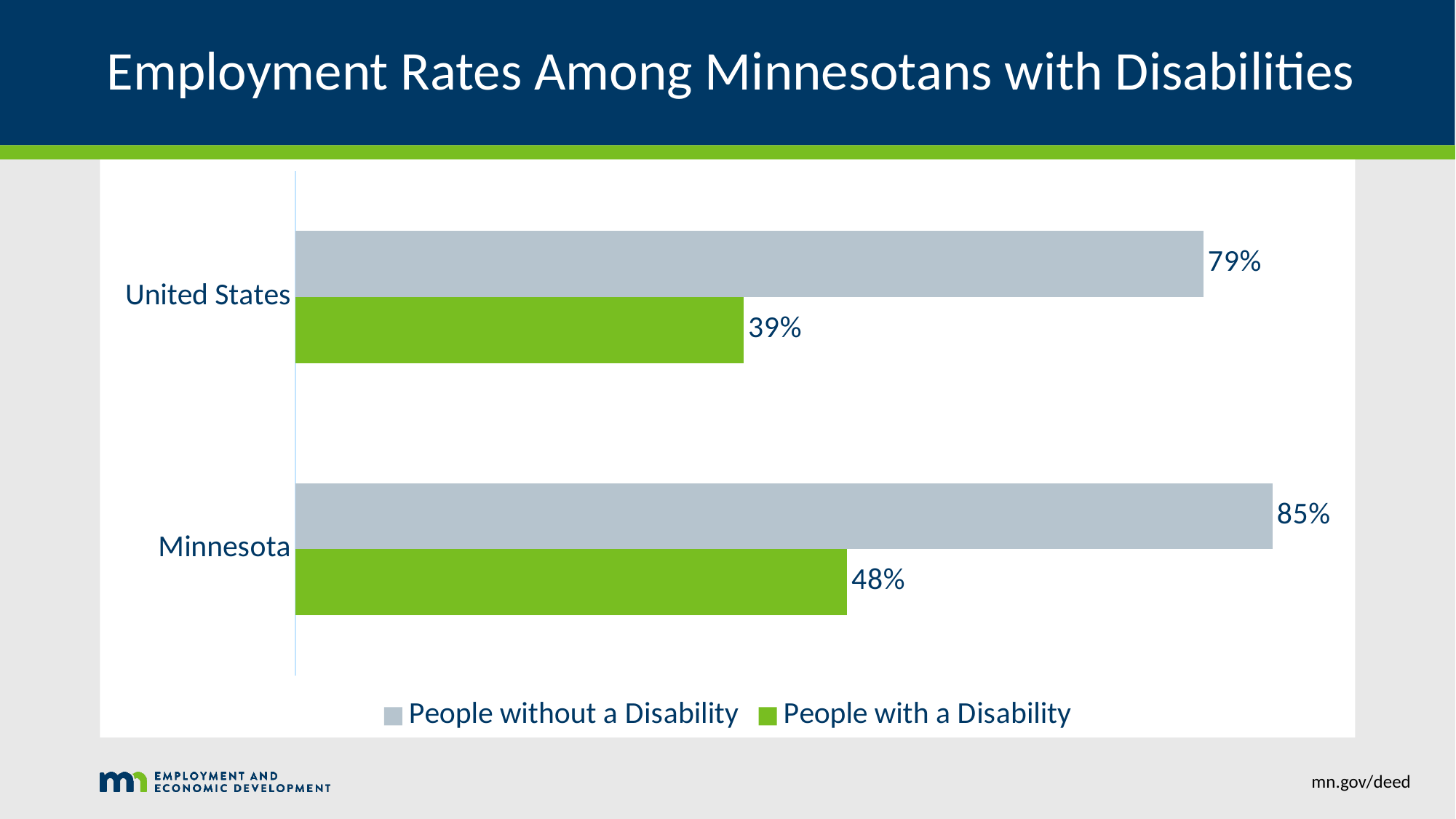
What is the employment rate for People without a Disability in Minnesota? 85% What is the employment rate for People with a Disability in Minnesota? 48% What is the employment rate for People with a Disability in the United States? 39% Which category has the highest value for People without a Disability? Minnesota How many series does the legend list? 2 What is the employment rate for People without a Disability in the United States? 79% Which is larger: the rate for People with a Disability in Minnesota or in the United States? Minnesota How many categories are shown on the chart? 2 What is the difference between the employment rates for People with a Disability in Minnesota and the United States? 9% What kind of chart is shown on the slide? Bar chart Which category has the lowest value for People with a Disability? United States What is the difference between the employment rates of People without a Disability and People with a Disability in Minnesota? 37%